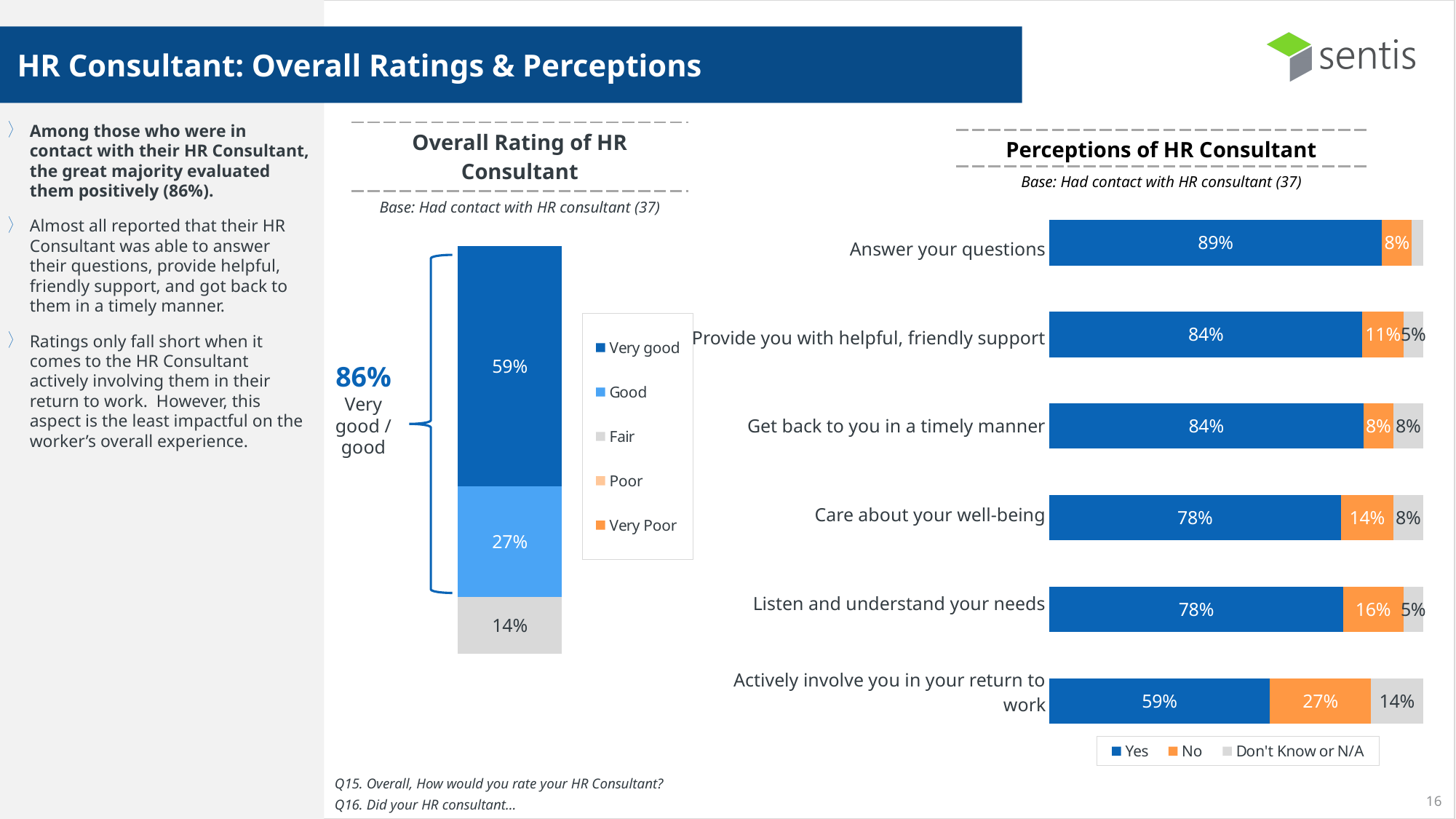
What type of chart is the 'Overall Rating of HR Consultant' chart? Stacked bar chart How many items are listed in the 'Perceptions of HR Consultant' chart? 6 In the 'Perceptions of HR Consultant' chart, which item has the lowest Yes percentage? Actively involve you in your return to work In the 'Overall Rating of HR Consultant' chart, what is the combined percentage for Very good and Good? 86% In the 'Perceptions of HR Consultant' chart, which item has the highest Yes percentage? Answer your questions In the 'Perceptions of HR Consultant' chart, which has a larger No percentage: 'Care about your well-being' or 'Listen and understand your needs'? Listen and understand your needs In the 'Perceptions of HR Consultant' chart, what percentage answered Yes for 'Answer your questions'? 89% In the 'Overall Rating of HR Consultant' chart, what percentage rated their HR Consultant as Very good? 59% In the 'Perceptions of HR Consultant' chart, what is the difference between the Yes percentages for 'Answer your questions' and 'Actively involve you in your return to work'? 30% In the 'Perceptions of HR Consultant' chart, what is the No percentage for 'Actively involve you in your return to work'? 27% How many series does the legend of the 'Perceptions of HR Consultant' chart list? 3 How many entries does the legend of the 'Overall Rating of HR Consultant' chart list? 5